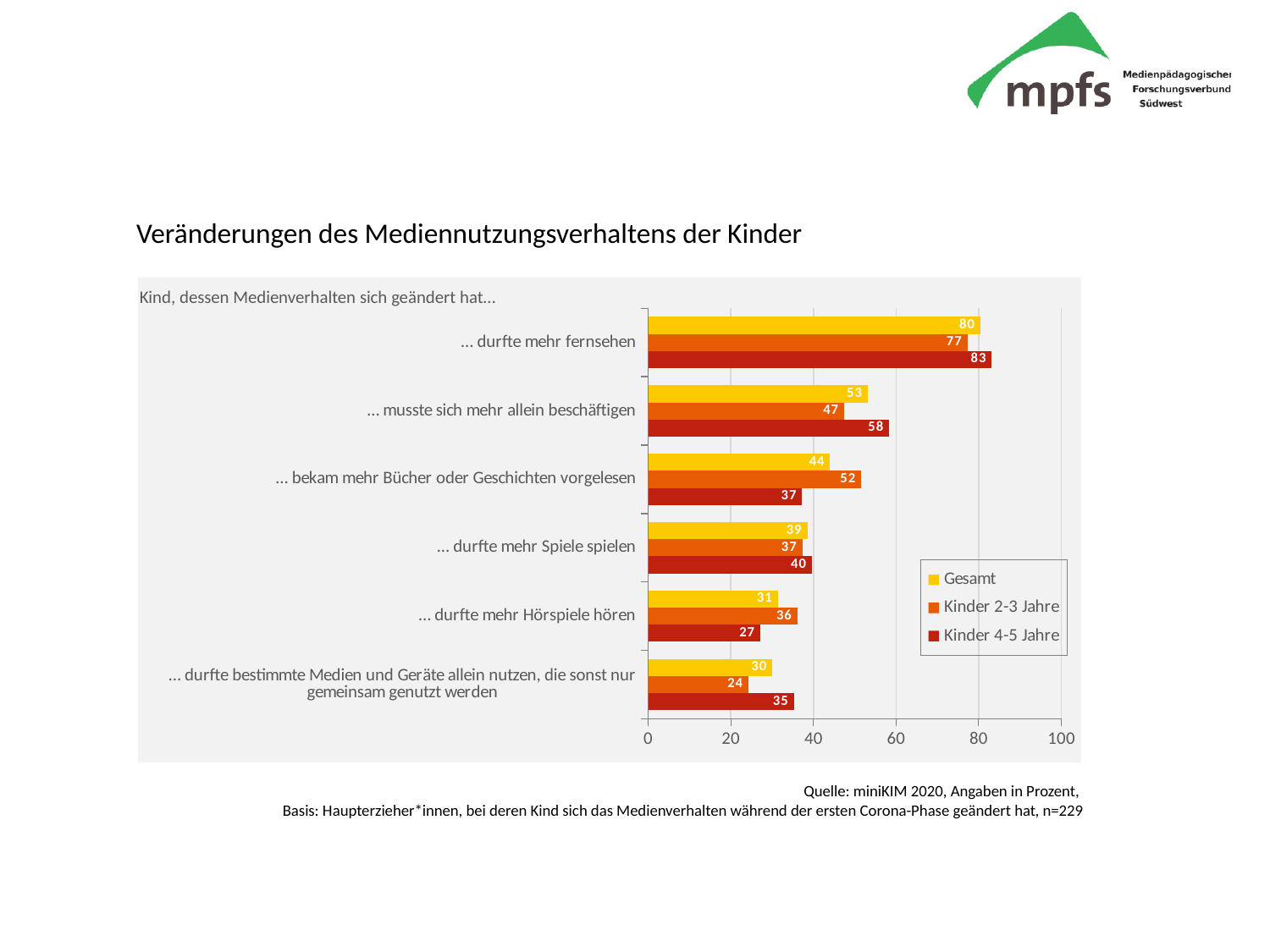
What is the difference between the Kinder 4-5 Jahre and Kinder 2-3 Jahre values for "… musste sich mehr allein beschäftigen"? 11 What is the value for Kinder 2-3 Jahre for "… bekam mehr Bücher oder Geschichten vorgelesen"? 52 Which category has the highest Gesamt value? … durfte mehr fernsehen What is the title of the slide? Veränderungen des Mediennutzungsverhaltens der Kinder How many categories are shown on the chart? 6 Which category has the lowest value for Kinder 2-3 Jahre? … durfte bestimmte Medien und Geräte allein nutzen, die sonst nur gemeinsam genutzt werden What kind of chart is shown on the slide? bar chart Is the Gesamt value for "… durfte mehr Spiele spielen" greater or less than 40? less For "… durfte mehr Hörspiele hören", which is larger: the value for Kinder 2-3 Jahre or Kinder 4-5 Jahre? Kinder 2-3 Jahre How many series does the legend list? 3 What is the Gesamt value for "… durfte mehr fernsehen"? 80 What is the value for Kinder 4-5 Jahre for "… durfte mehr Hörspiele hören"? 27